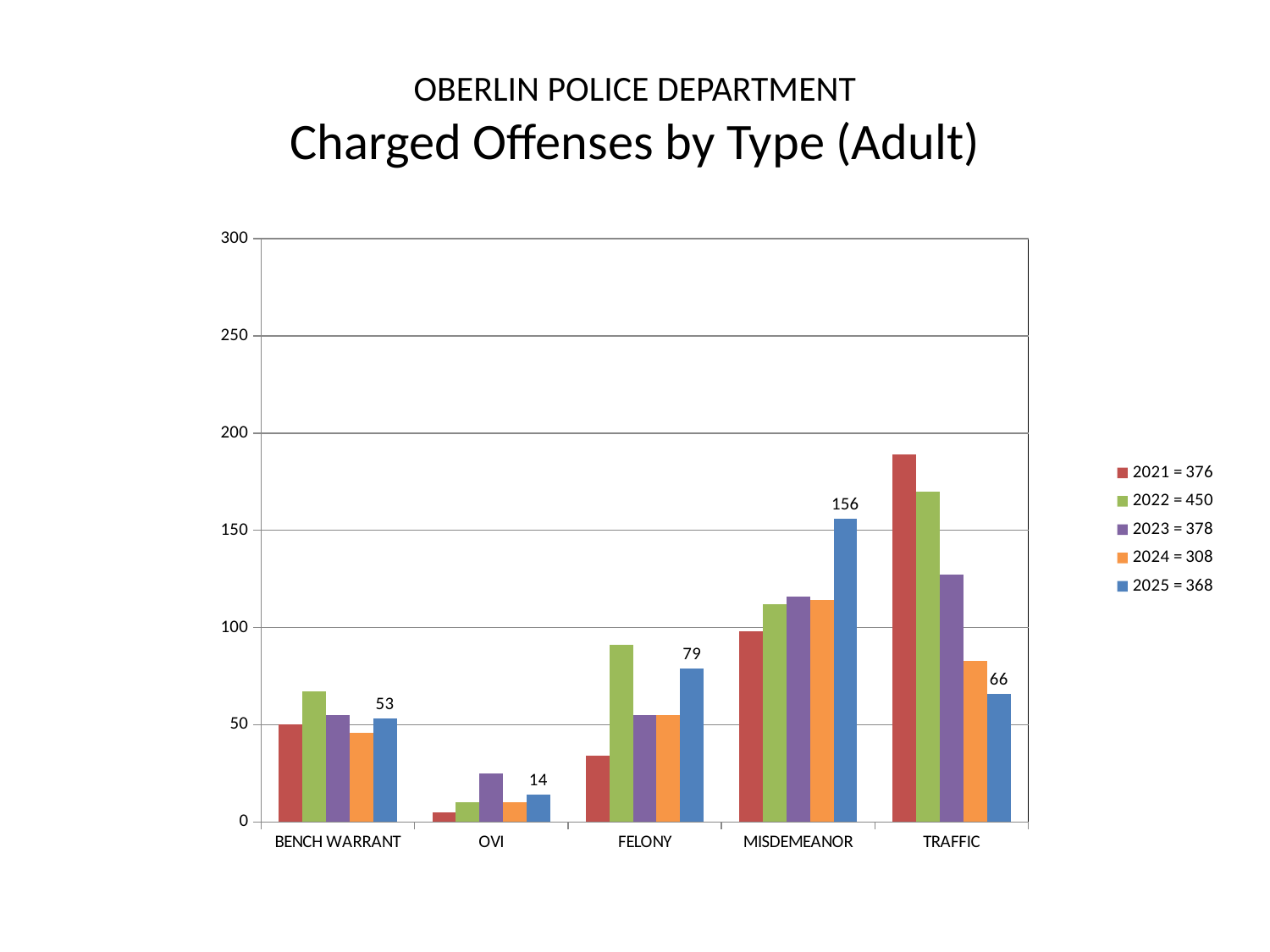
Which category has the highest value in the 2025 series? MISDEMEANOR How many series does the legend list? 5 What is the difference between the 2025 values for MISDEMEANOR and FELONY? 77 Is the value for OVI in the 2021 series greater or less than 50? less Which category has the lowest value in the 2025 series? OVI What is the value for MISDEMEANOR in the 2025 series? 156 What is the value for TRAFFIC in the 2025 series? 66 What is the value for OVI in the 2025 series? 14 How many offense categories are shown on the x axis? 5 In the 2025 series, which is larger: FELONY or TRAFFIC? FELONY What kind of chart is shown on the slide? bar chart Is the value for TRAFFIC in the 2021 series greater or less than 150? greater